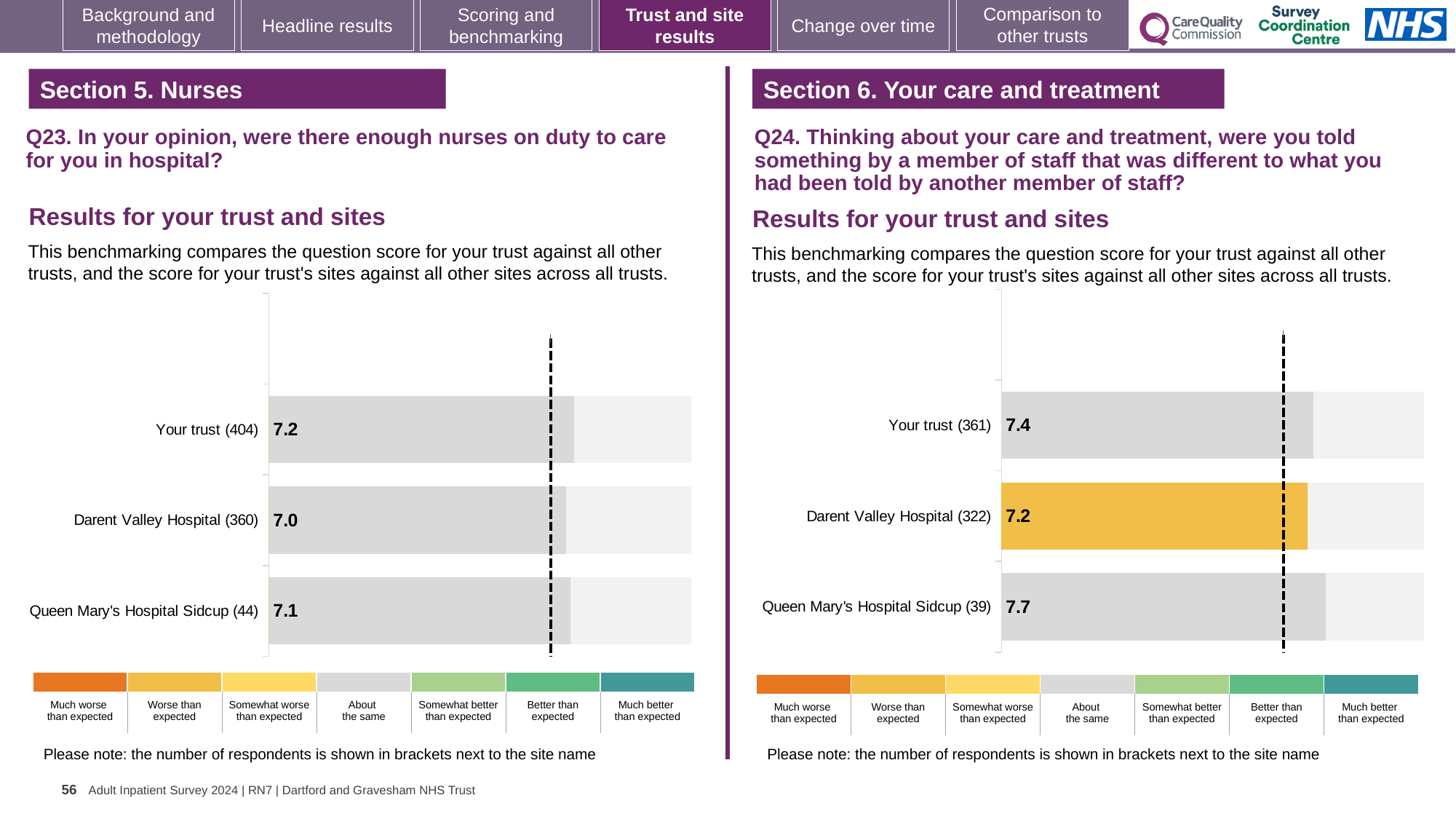
What type of chart is used on the Q23 chart (left)? Bar chart On the Q23 chart (left), how many bars are plotted? 3 On the Q23 chart (left), what is the score for Your trust (404)? 7.2 On the Q24 chart (right), which site or trust has the highest score? Queen Mary's Hospital Sidcup (39) On the Q24 chart (right), what is the score for Queen Mary's Hospital Sidcup (39)? 7.7 On the Q23 chart (left), what is the score for Darent Valley Hospital (360)? 7.0 On the Q24 chart (right), what is the difference between the scores for Queen Mary's Hospital Sidcup (39) and Your trust (361)? 0.3 On the Q23 chart (left), what is the difference between the scores for Your trust (404) and Darent Valley Hospital (360)? 0.2 On the Q24 chart (right), which has the larger score: Your trust (361) or Darent Valley Hospital (322)? Your trust (361) On the Q24 chart (right), which bar is coloured yellow/orange rather than grey? Darent Valley Hospital (322) On the Q24 chart (right), what is the score for Darent Valley Hospital (322)? 7.2 On the Q23 chart (left), which site or trust has the lowest score? Darent Valley Hospital (360)